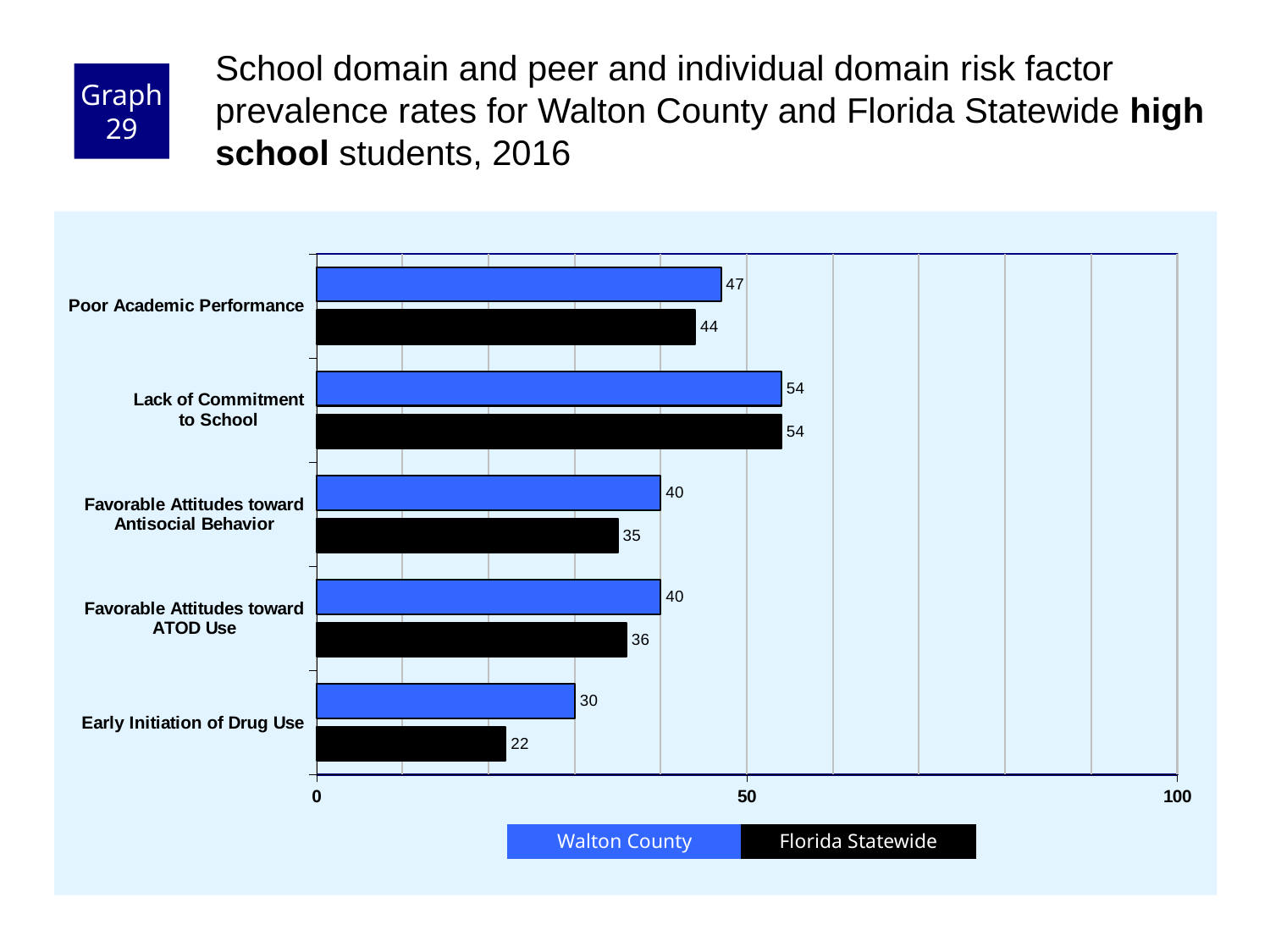
What is the difference between the Walton County and Florida Statewide values for Early Initiation of Drug Use? 8 How many series does the legend list? 2 What is the Florida Statewide value for Favorable Attitudes toward ATOD Use? 36 Which is larger for Poor Academic Performance: the Walton County value or the Florida Statewide value? Walton County What is the difference between the Walton County and Florida Statewide values for Favorable Attitudes toward Antisocial Behavior? 5 What is the Florida Statewide value for Early Initiation of Drug Use? 22 Which risk factor has the highest Walton County value? Lack of Commitment to School How many risk factor categories are shown on the chart? 5 What is the Walton County value for Poor Academic Performance? 47 Which risk factor has the lowest Florida Statewide value? Early Initiation of Drug Use Is the Walton County value for Lack of Commitment to School greater or less than 50? greater What kind of chart is shown on the slide? bar chart